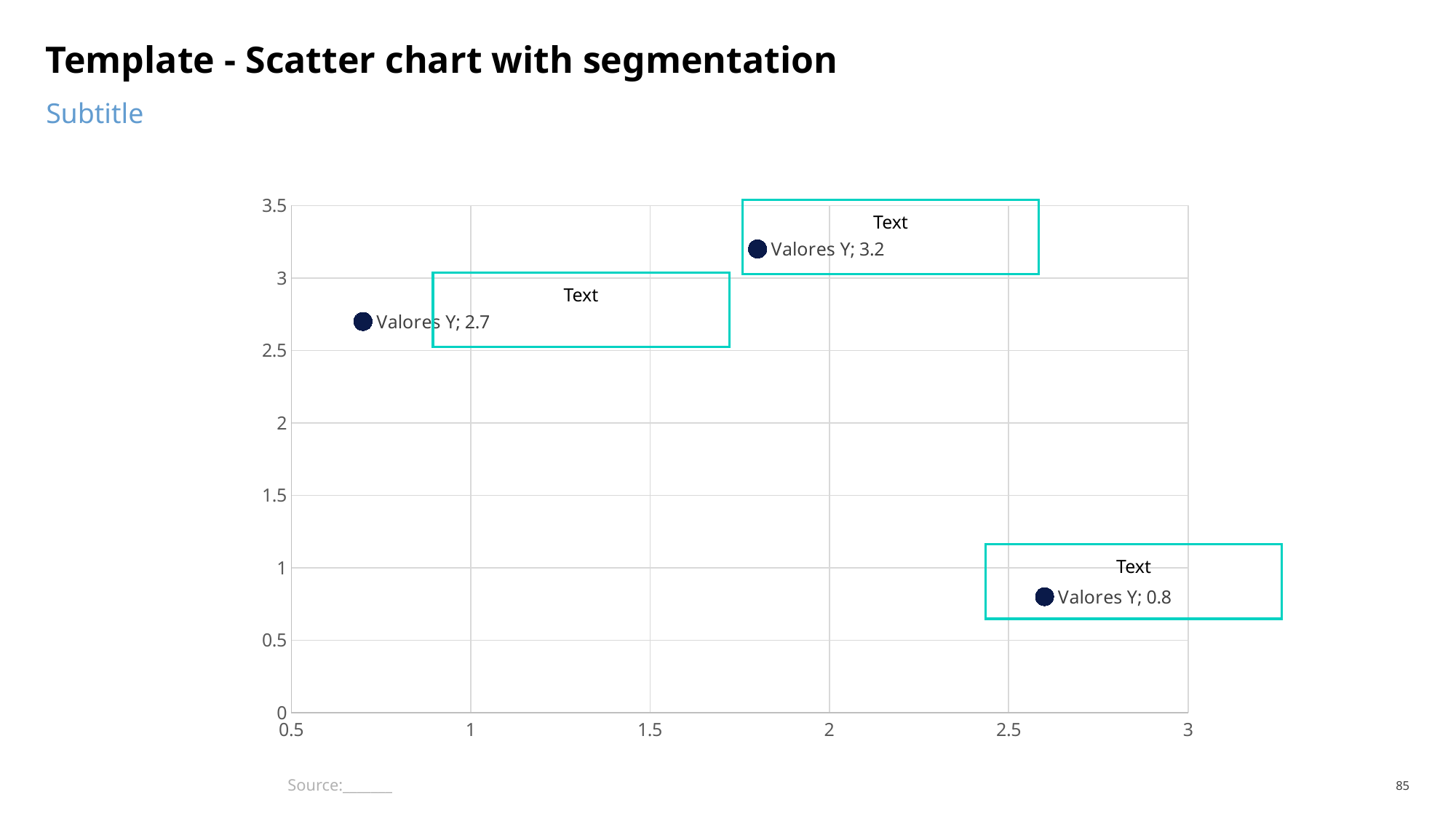
Is the x value of the point labelled 'Valores Y; 2.7' greater or less than 1? less Which is larger, the Y value of the leftmost point or the Y value of the rightmost point? the leftmost point (2.7) What series name appears in the data labels of the points? Valores Y How many data points are plotted on the chart? 3 What is the Y value of the middle point (the one near x = 2)? 3.2 What is the Y value of the rightmost point on the chart? 0.8 What kind of chart is shown on the slide? scatter chart What is the difference between the highest Y value (3.2) and the lowest Y value (0.8)? 2.4 Which point has the lowest Y value? the rightmost point, Valores Y; 0.8 Which point has the highest Y value? the middle point, Valores Y; 3.2 Is the x value of the point labelled 'Valores Y; 0.8' greater or less than 2.5? greater What is the Y value of the leftmost point on the chart? 2.7